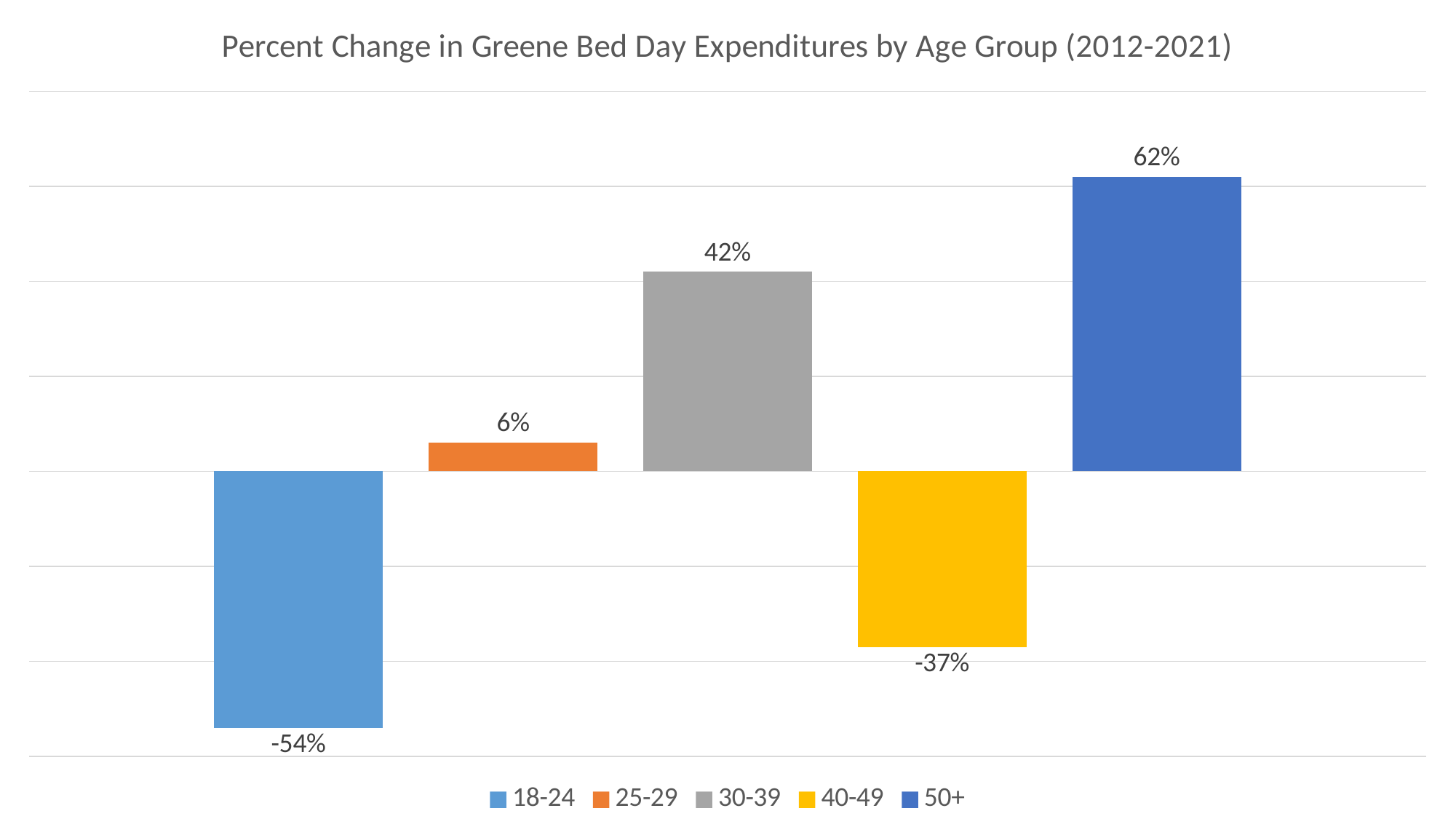
Which age group has a larger percent change, 25-29 or 30-39? 30-39 What is the percent change for the 30-39 age group? 42% What is the percent change in Greene bed day expenditures for the 18-24 age group? -54% What is the percent change for the 25-29 age group? 6% Which age group has the lowest percent change? 18-24 Which age group has the highest percent change? 50+ What type of chart is shown on the slide? Bar chart What is the percent change for the 50+ age group? 62% What is the percent change for the 40-49 age group? -37% What is the difference between the percent change for the 50+ group and the 30-39 group? 20 percentage points What is the title of the chart? Percent Change in Greene Bed Day Expenditures by Age Group (2012-2021) How many age groups are shown in the chart? 5